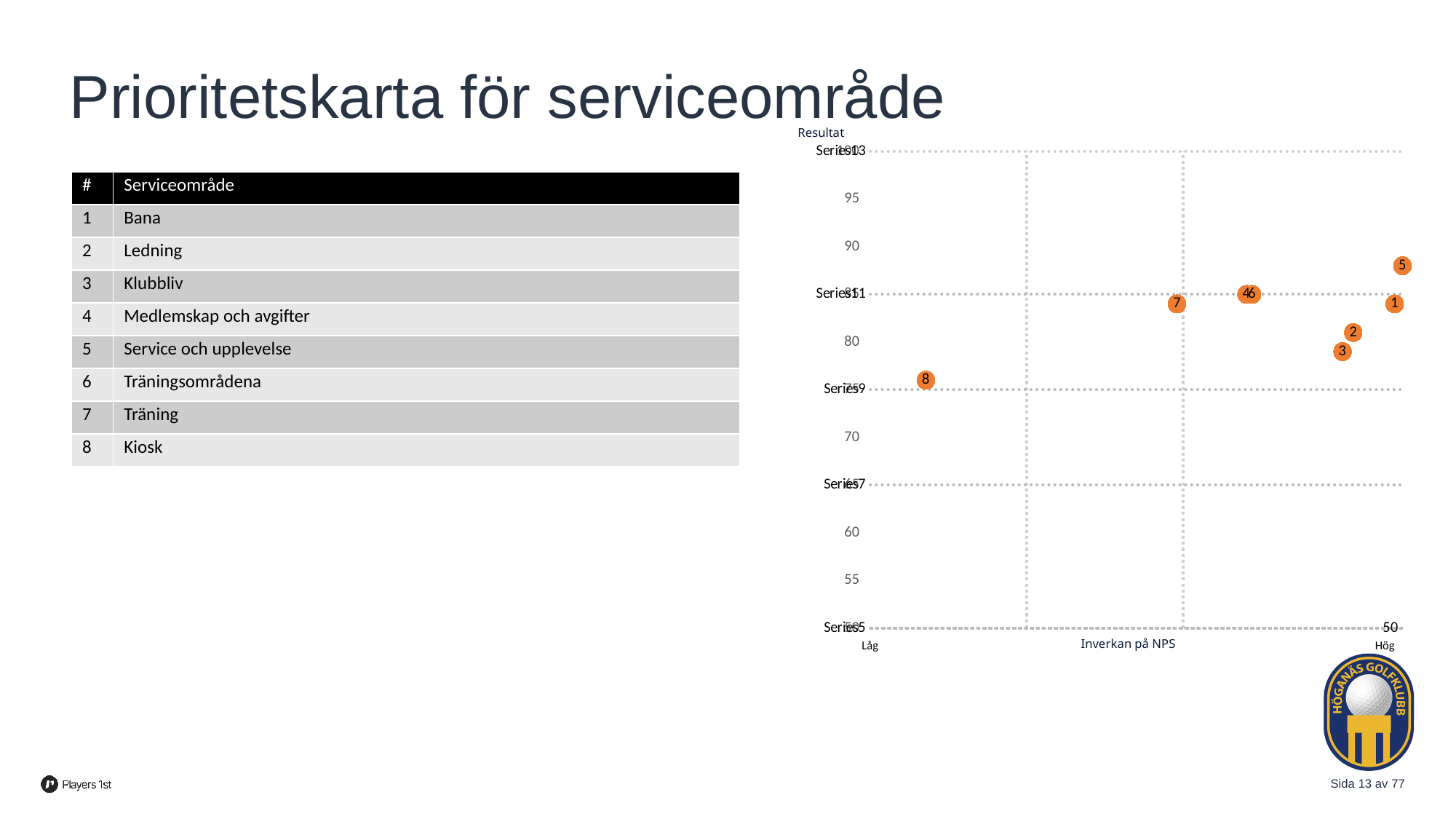
Which numbered point is furthest to the left (lowest Inverkan på NPS) on the chart? 8 Which numbered point has the lowest Resultat value on the chart? 8 What kind of chart is shown on the slide? scatter chart How many numbered points are plotted on the chart? 8 Is the Resultat value for point 5 greater or less than 85? greater What is the title of the horizontal axis of the chart? Inverkan på NPS Is the Resultat value for point 8 greater or less than 80? less Is the Resultat value for point 7 greater or less than 80? greater What is the title of the vertical axis of the chart? Resultat Which numbered point has the highest Resultat value on the chart? 5 Which has a higher Resultat value, point 5 or point 8? point 5